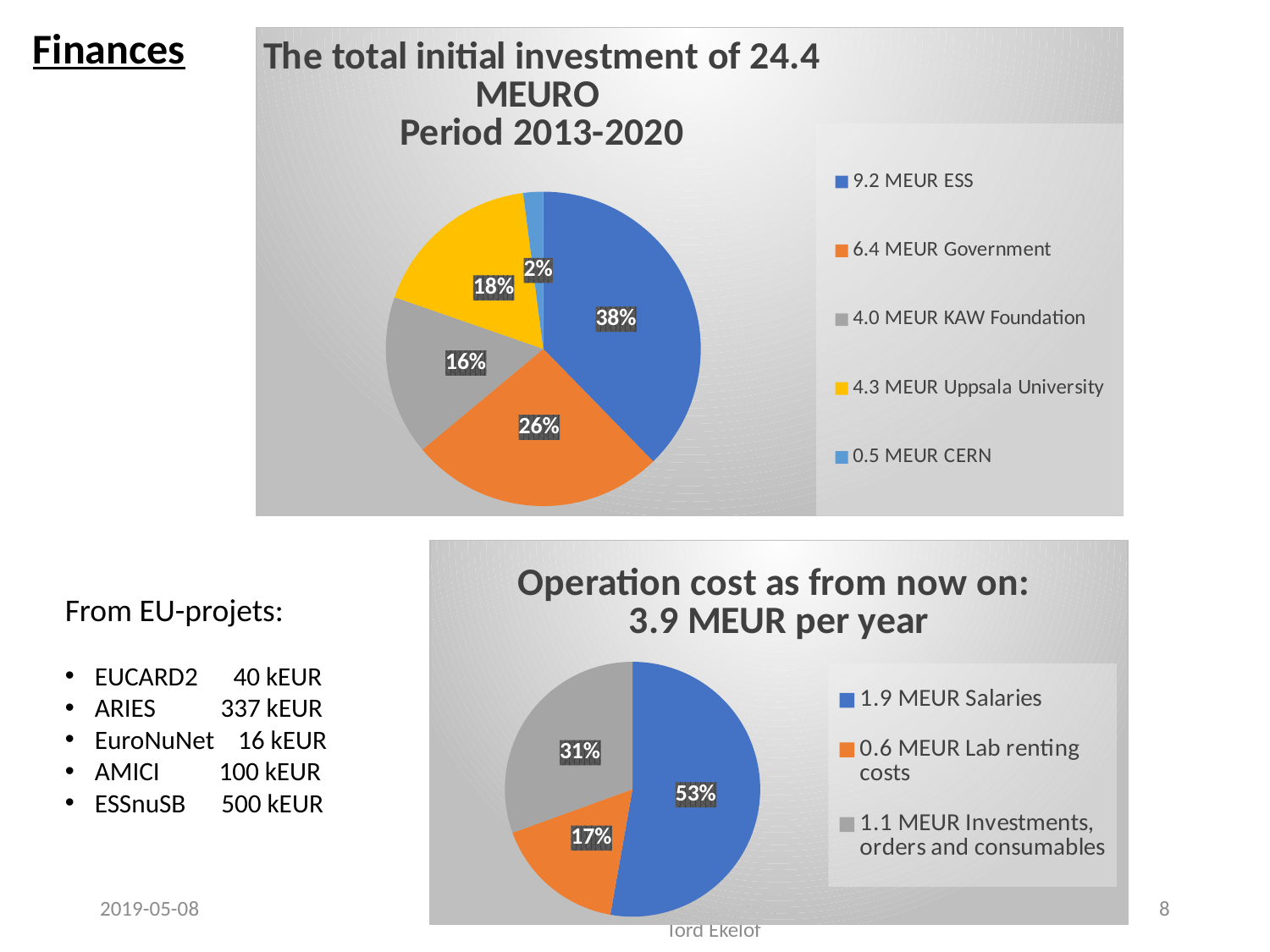
In the 'total initial investment' pie chart, how many slices are there? 5 In the 'total initial investment' pie chart, what is the difference in percentage points between the Government share and the Uppsala University share? 8 In the 'total initial investment' pie chart, which is larger: the Uppsala University share or the KAW Foundation share? Uppsala University In the 'total initial investment' pie chart, which contributor has the smallest slice? CERN According to the legend of the 'total initial investment' pie chart, how many MEUR did the Government contribute? 6.4 MEUR In the 'Operation cost as from now on' pie chart, what share do Salaries have? 53% In the 'total initial investment' pie chart, which contributor has the largest slice? ESS What kind of chart is the 'Operation cost as from now on' chart? pie chart In the 'Operation cost as from now on' pie chart, which category has the smallest slice? Lab renting costs In the 'total initial investment' pie chart, what share does the KAW Foundation have? 16% In the 'total initial investment' pie chart, what share does ESS have? 38% In the 'Operation cost as from now on' pie chart, what is the difference in percentage points between Salaries and Investments, orders and consumables? 22